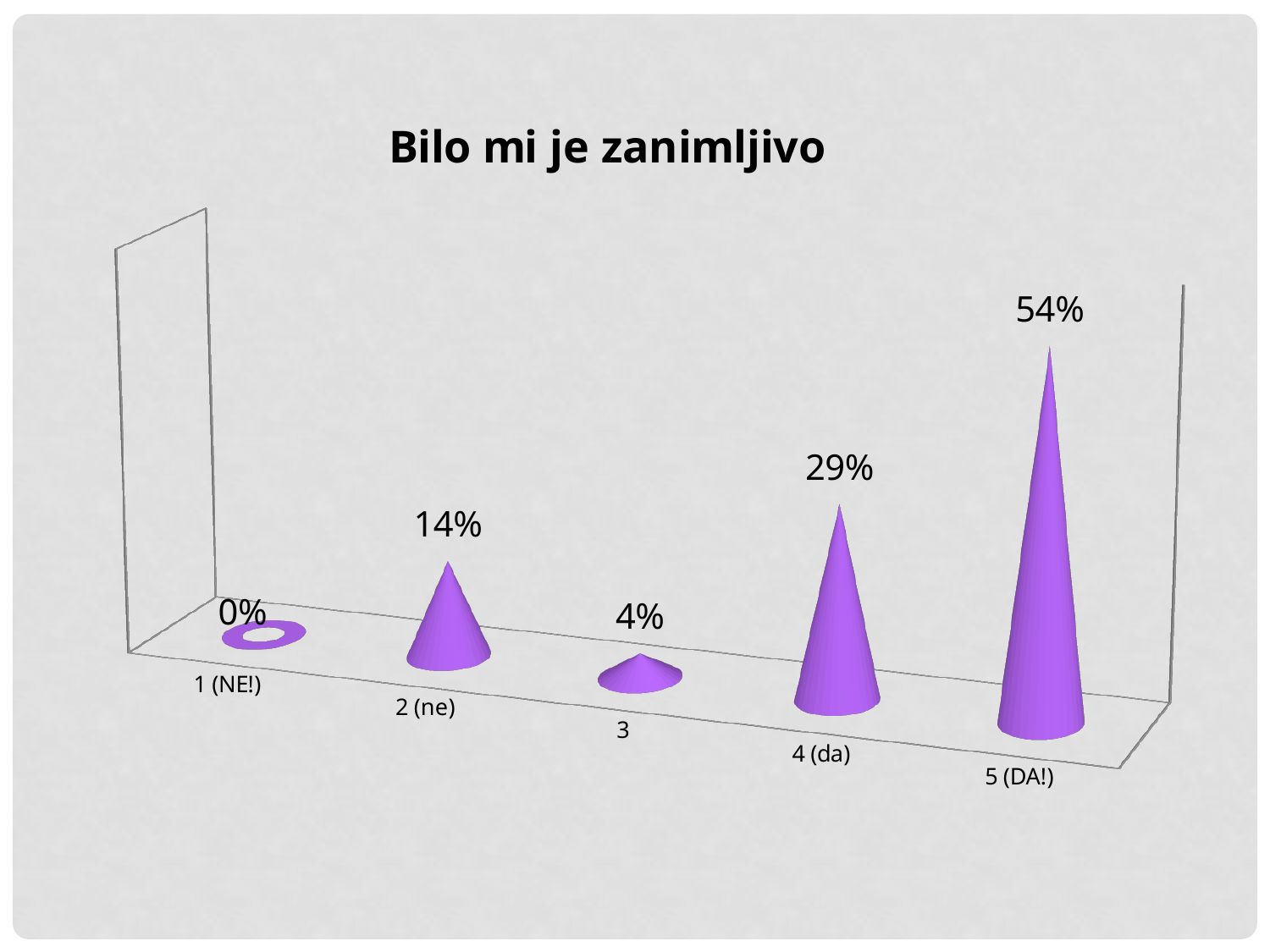
What is the value for 4 (da)? 29% What is the value for 2 (ne)? 14% Which category has the highest value? 5 (DA!) What is the value for 1 (NE!)? 0% Which category has the lowest value? 1 (NE!) How many categories are shown on the chart? 5 What is the title of the chart? Bilo mi je zanimljivo What kind of chart is this? bar chart What is the difference between the values for 5 (DA!) and 4 (da)? 25% What is the value for category 3? 4% Which is larger, the value for 2 (ne) or the value for 3? 2 (ne) What is the value for 5 (DA!)? 54%